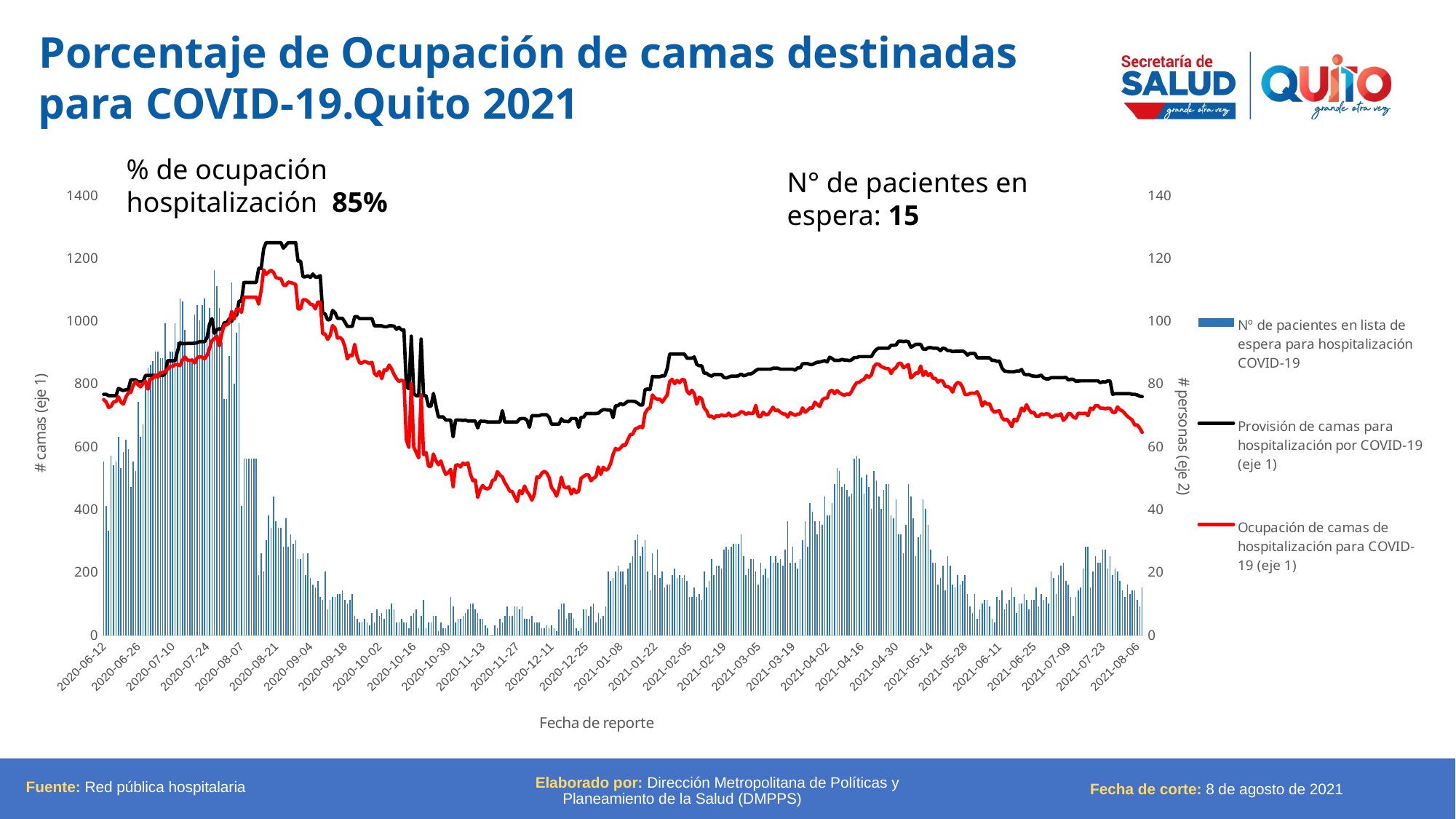
Is the peak value of 'Provisión de camas para hospitalización por COVID-19' around 2020-08-21 greater or less than 1200? greater What kind of chart is shown on the slide? A combined bar and line chart Is the value of 'Provisión de camas para hospitalización por COVID-19' around 2020-11-13 greater or less than 800? less What is the percentage of hospitalization bed occupancy stated on the slide? 85% How many series does the legend list? 3 How many patients are waiting (N° de pacientes en espera) according to the slide? 15 Does the 'Ocupación de camas de hospitalización para COVID-19' line rise or fall between 2021-07-23 and 2021-08-06? Fall Around 2020-08-21, which line is higher: 'Provisión de camas' or 'Ocupación de camas'? Provisión de camas Does the 'Provisión de camas para hospitalización por COVID-19' line rise or fall between 2020-06-12 and 2020-08-21? Rise Is the highest bar for 'N° de pacientes en lista de espera' around 2021-04-16 greater or less than 40 on the right axis? greater What is the label of the x axis? Fecha de reporte